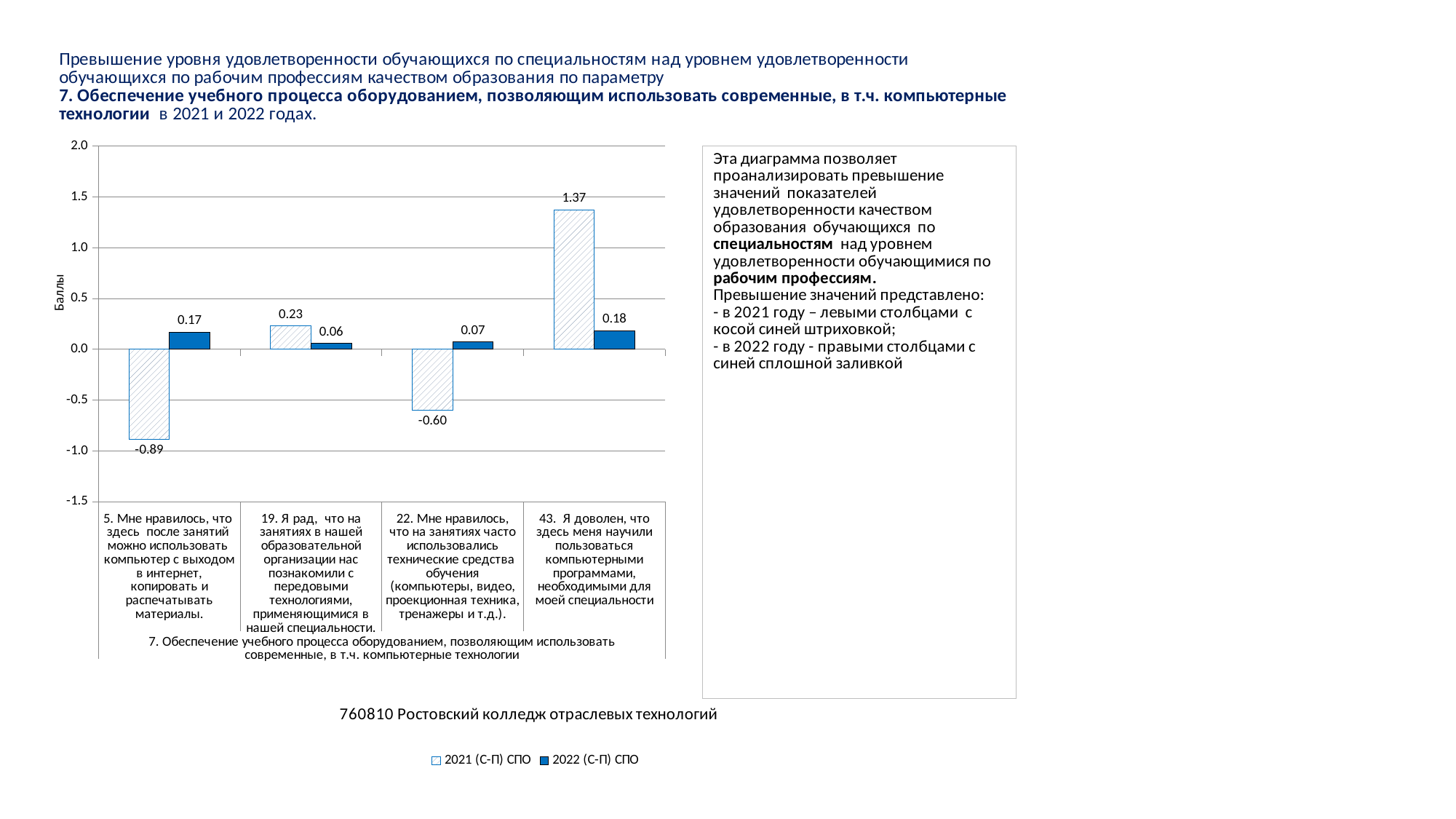
How many series does the legend list? 2 Which category has the highest 2022 (С-П) СПО value? 43. Я доволен, что здесь меня научили пользоваться компьютерными программами, необходимыми для моей специальности What is the 2022 (С-П) СПО value for category 19 (Я рад, что на занятиях в нашей образовательной организации нас познакомили с передовыми технологиями)? 0.06 What is the label of the vertical axis of the chart? Баллы How many categories are shown on the x axis of the chart? 4 What is the 2021 (С-П) СПО value for category 43 (Я доволен, что здесь меня научили пользоваться компьютерными программами)? 1.37 What is the 2021 (С-П) СПО value for category 22 (Мне нравилось, что на занятиях часто использовались технические средства обучения)? -0.60 What is the difference between the 2021 and 2022 (С-П) СПО values for category 43? 1.19 What kind of chart is shown on the slide? Bar chart Which is larger for category 19: the 2021 (С-П) СПО value or the 2022 (С-П) СПО value? 2021 (С-П) СПО Which category has the lowest 2021 (С-П) СПО value? 5. Мне нравилось, что здесь после занятий можно использовать компьютер с выходом в интернет, копировать и распечатывать материалы. What is the 2022 (С-П) СПО value for category 5 (Мне нравилось, что здесь после занятий можно использовать компьютер с выходом в интернет)? 0.17